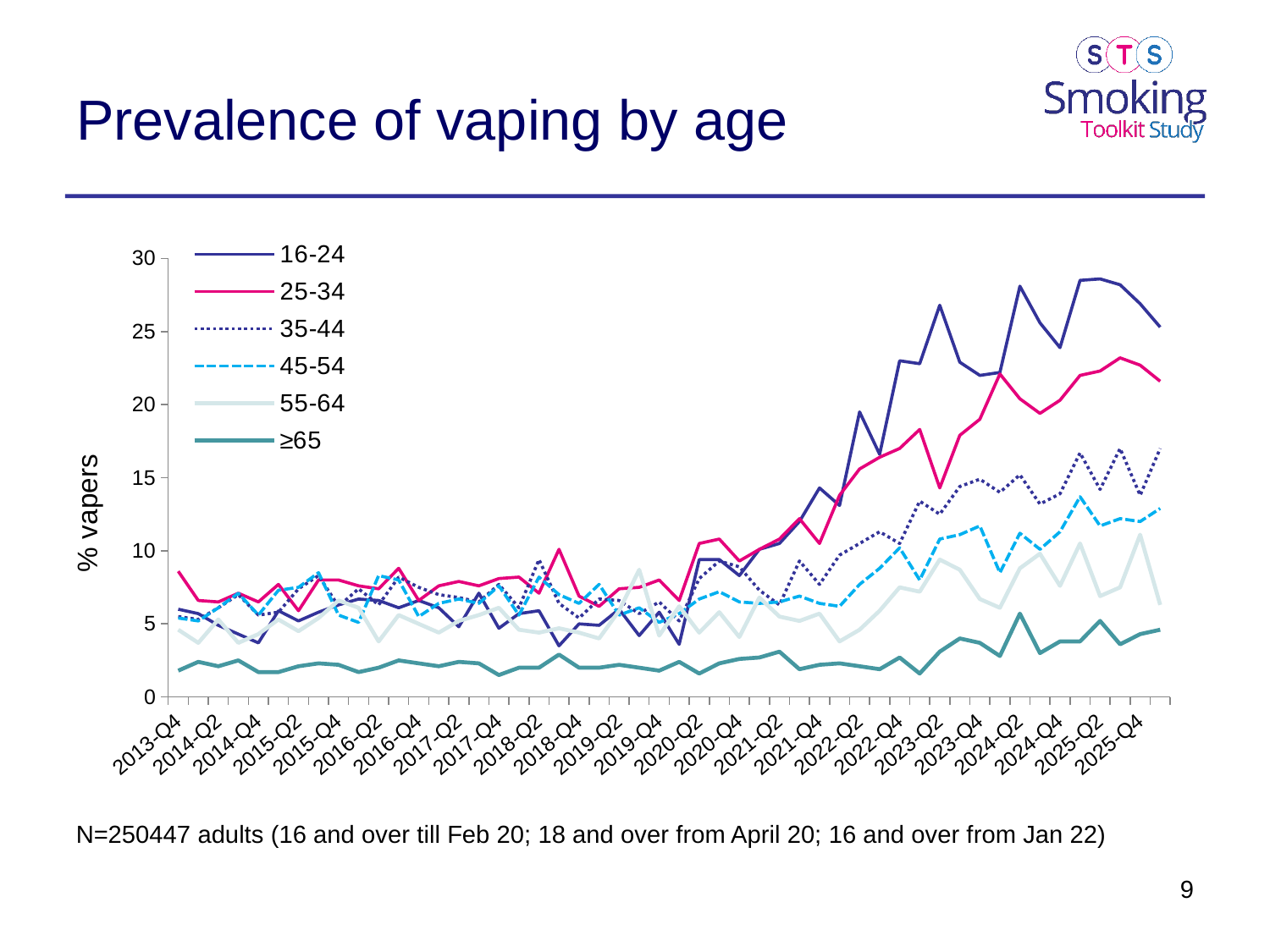
How many age groups does the legend list? 6 What is the label on the vertical axis? % vapers Does the vaping prevalence for the 16-24 group rise or fall between 2020-Q4 and 2025-Q2? rise What kind of chart is shown on the slide? line chart Is the value for the ≥65 group at 2025-Q4 greater or less than 10? less Is the value for the 16-24 group at 2025-Q2 greater or less than 25? greater Is the value for the 16-24 group at 2013-Q4 greater or less than 10? less At 2025-Q4, which is larger: the value for 25-34 or the value for 35-44? 25-34 What is the title of the chart? Prevalence of vaping by age Which age group has the highest vaping prevalence at 2025-Q4? 16-24 Which age group has the lowest vaping prevalence across the whole period? ≥65